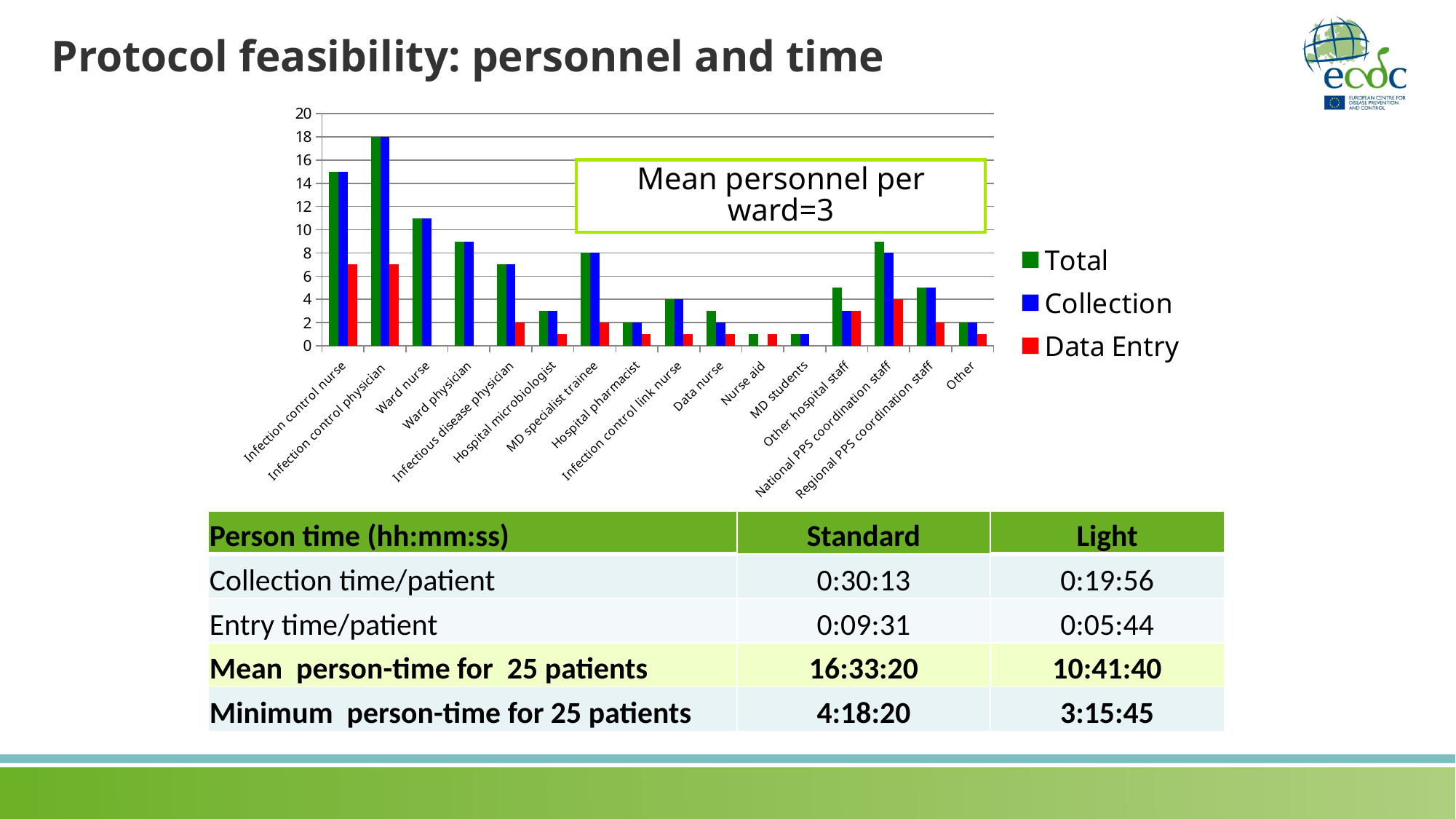
How many series does the chart legend list? 3 How many personnel categories are shown on the x axis of the chart? 16 What is the Data Entry value for National PPS coordination staff? 4 What does the text box inside the chart say? Mean personnel per ward=3 What is the Total value for MD specialist trainee? 8 What are the three series named in the chart legend? Total, Collection, Data Entry Which has a larger Total value: Infection control nurse or Ward nurse? Infection control nurse Which personnel category has the highest Total value in the chart? Infection control physician Is the Total value for Ward physician greater or less than 10? less What is the Total value for Infection control physician? 18 Is the Total value for Ward nurse greater or less than 10? greater What kind of chart is shown on the slide? bar chart